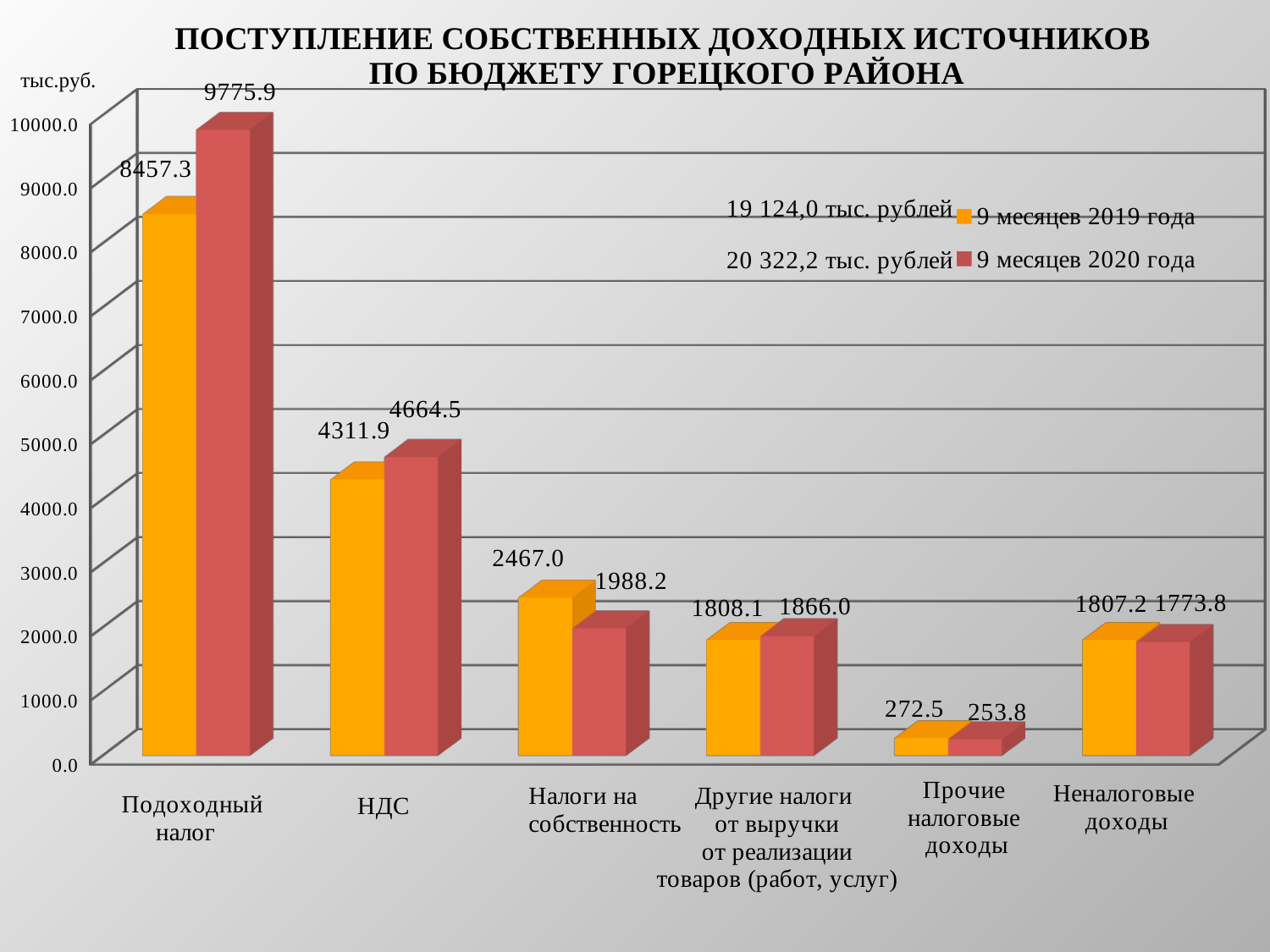
How many series does the legend list? 2 What is the value for Прочие налоговые доходы in the 9 месяцев 2020 года series? 253.8 What is the difference between the 2020 and 2019 values for Подоходный налог? 1318.6 How many categories are shown on the x axis? 6 Is the value for НДС in the 9 месяцев 2020 года series greater or less than 4000.0? greater What is the value for НДС in the 9 месяцев 2019 года series? 4311.9 What is the value for Подоходный налог in the 9 месяцев 2020 года series? 9775.9 For Налоги на собственность, which series has the larger value: 9 месяцев 2019 года or 9 месяцев 2020 года? 9 месяцев 2019 года What kind of chart is shown on the slide? Bar chart Which category has the lowest value in the 9 месяцев 2020 года series? Прочие налоговые доходы Which category has the highest value in the 9 месяцев 2019 года series? Подоходный налог What unit is shown at the top of the vertical axis? тыс.руб.